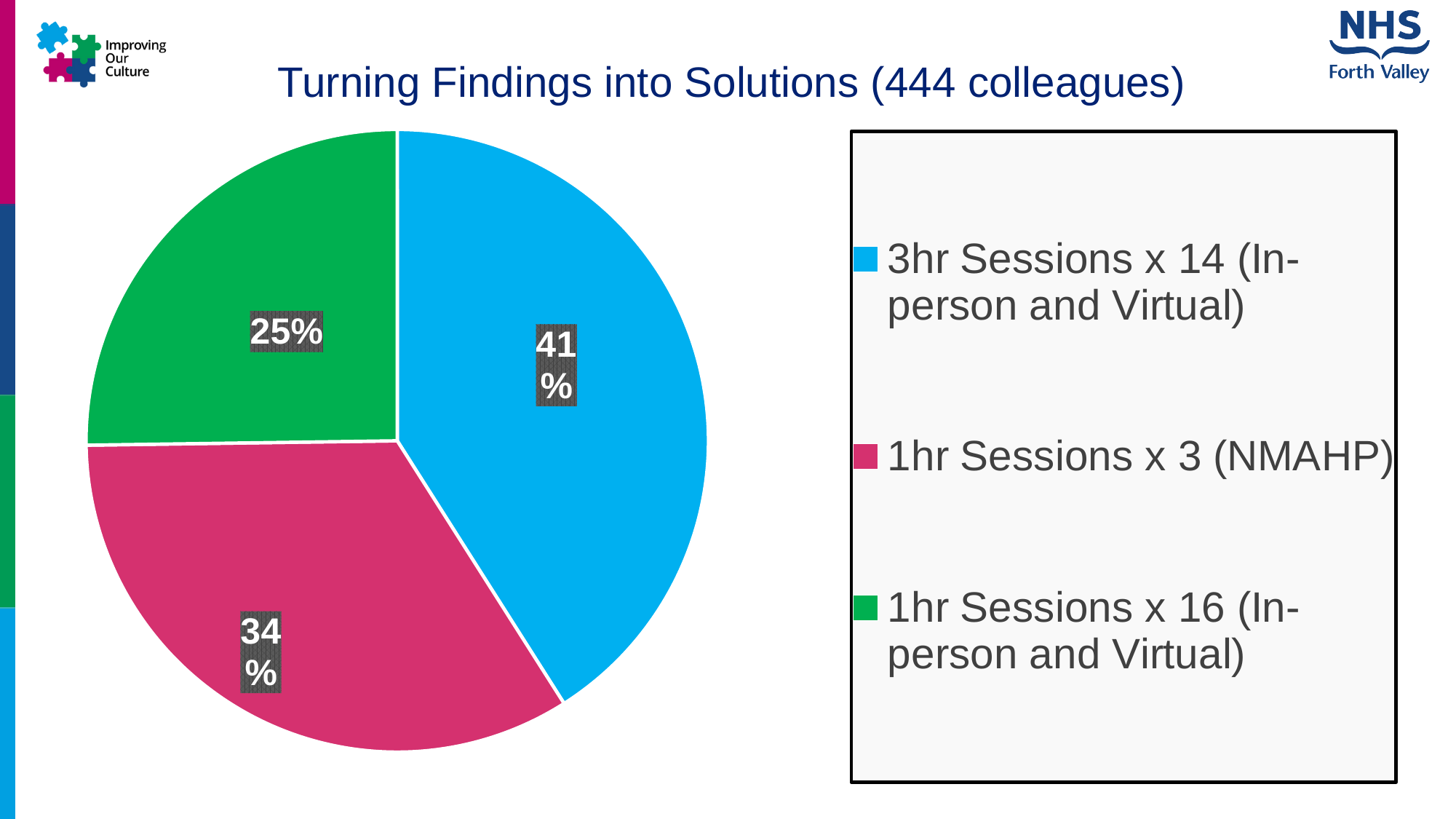
How many slices does the pie chart have? 3 What share of the pie is taken by 1hr Sessions x 3 (NMAHP)? 34% Which category has the smallest slice of the pie? 1hr Sessions x 16 (In-person and Virtual) What kind of chart is shown on the slide? Pie chart What colour is the slice for 1hr Sessions x 3 (NMAHP)? Pink/magenta Which category has the largest slice of the pie? 3hr Sessions x 14 (In-person and Virtual) How many entries does the legend list? 3 What is the difference in percentage points between the 1hr Sessions x 3 (NMAHP) slice and the 1hr Sessions x 16 slice? 9 What share of the pie is taken by 1hr Sessions x 16 (In-person and Virtual)? 25% What share of the pie is taken by 3hr Sessions x 14 (In-person and Virtual)? 41% Which is larger: the slice for 1hr Sessions x 3 (NMAHP) or the slice for 1hr Sessions x 16 (In-person and Virtual)? 1hr Sessions x 3 (NMAHP) What is the difference in percentage points between the 3hr Sessions x 14 slice and the 1hr Sessions x 16 slice? 16